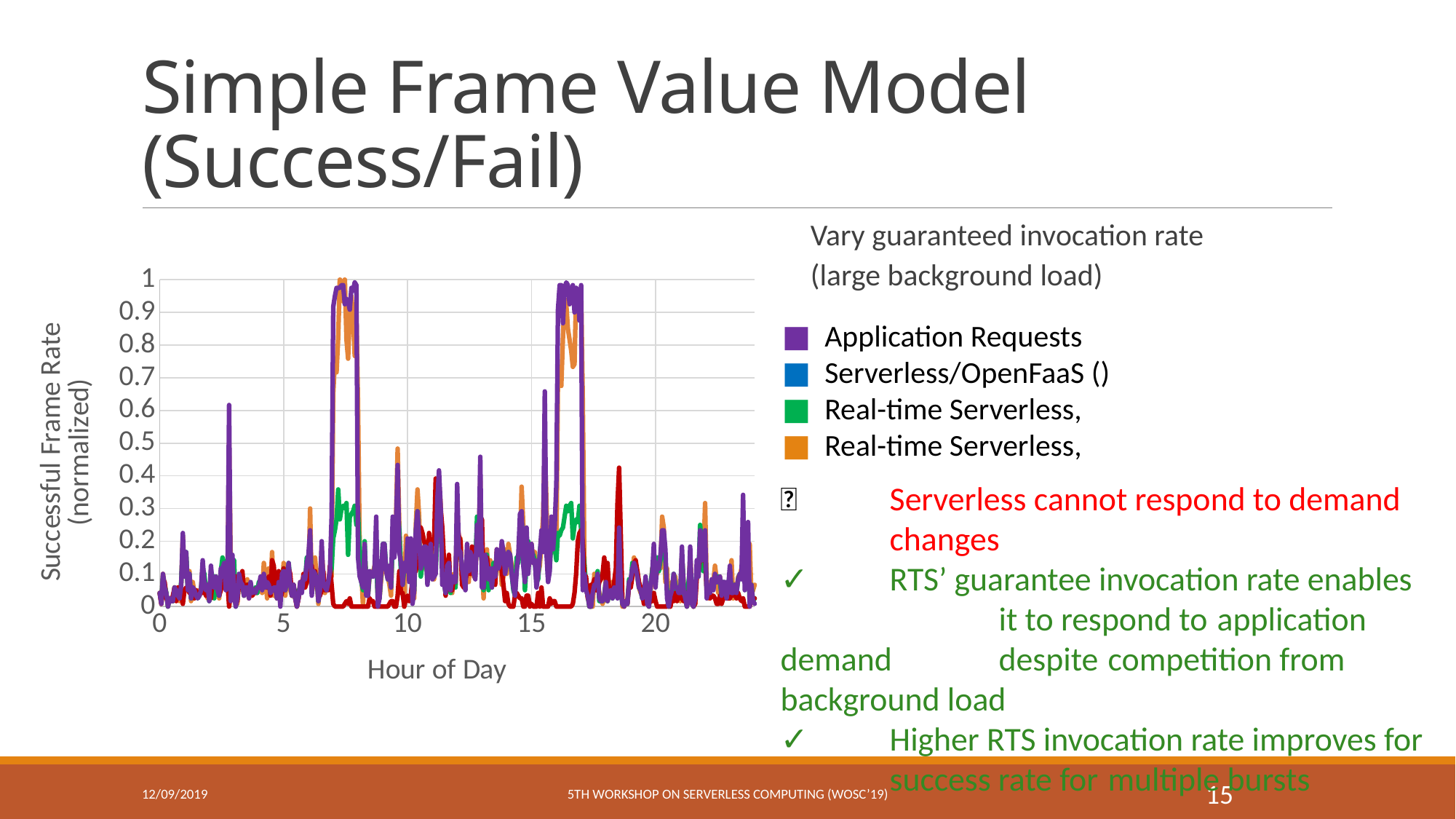
Is the spike of the purple Application Requests line near hour 3 greater or less than 0.5? greater What is the highest value shown on the y axis? 1 How many labeled tick values are shown on the x axis? 5 How many series does the legend list? 4 Is the spike of the red line near hour 18 to 19 greater or less than 0.5? less What kind of chart is shown on the slide? line chart What is the label of the y axis of the chart? Successful Frame Rate (normalized) What is the label of the x axis of the chart? Hour of Day Is the peak value of the purple Application Requests line around hour 7 to 8 greater or less than 0.9? greater Around hour 16 to 17, which line reaches a higher value: the purple Application Requests line or the green Real-time Serverless line? purple Application Requests